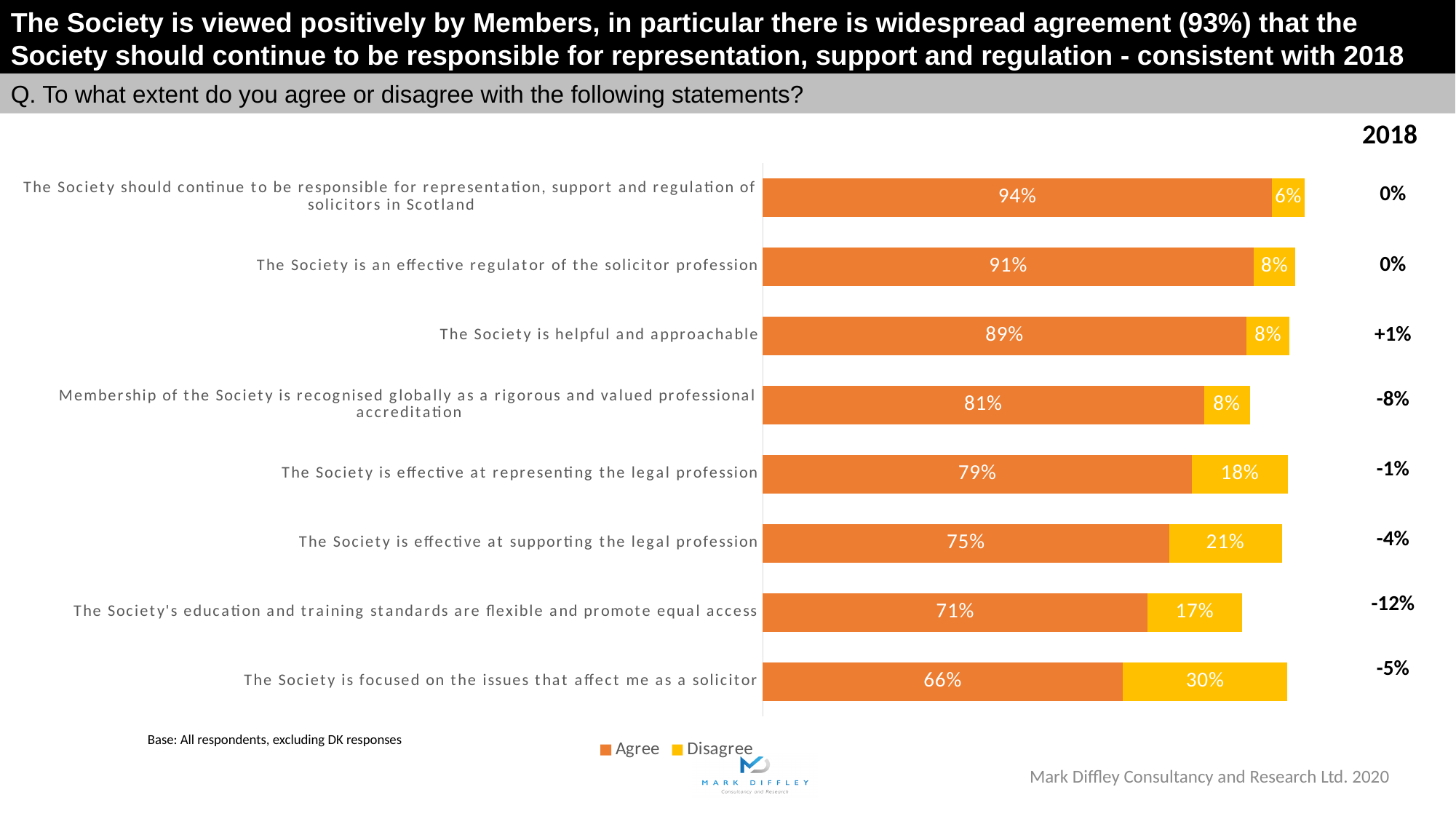
Which has a larger Disagree percentage: 'The Society is effective at representing the legal profession' or 'The Society's education and training standards are flexible and promote equal access'? The Society is effective at representing the legal profession How many series does the legend list? 2 What is the Disagree value for 'The Society is effective at supporting the legal profession'? 21% What kind of chart is shown on the slide? Stacked bar chart Which statement has the lowest Agree percentage? The Society is focused on the issues that affect me as a solicitor What is the combined Agree and Disagree total for 'The Society is effective at supporting the legal profession'? 96% What is the Agree value for 'The Society is an effective regulator of the solicitor profession'? 91% What is the difference between the Agree percentages for 'The Society is helpful and approachable' and 'The Society is effective at representing the legal profession'? 10% How many statements are shown in the chart? 8 Which statement has the highest Agree percentage? The Society should continue to be responsible for representation, support and regulation of solicitors in Scotland What percentage of respondents agree that the Society should continue to be responsible for representation, support and regulation of solicitors in Scotland? 94% What percentage of respondents disagree that the Society is focused on the issues that affect me as a solicitor? 30%